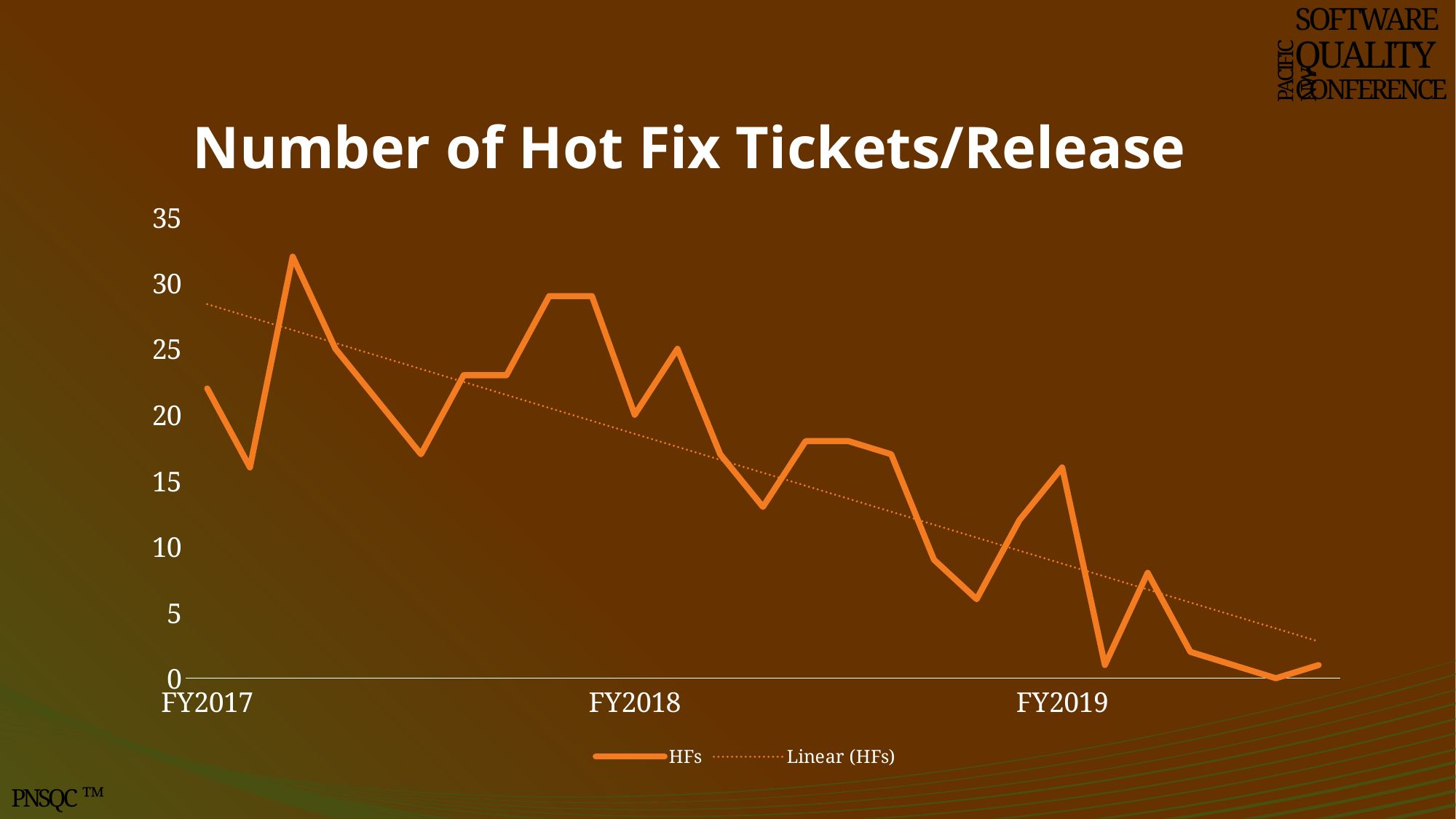
Is the HFs value at the FY2019 label greater or less than 10? greater Does the dotted Linear (HFs) trendline slope upward or downward across the chart? downward What kind of chart is shown on the slide? line chart Is the HFs value at the FY2018 label greater or less than 15? greater What are the two entries in the chart legend? HFs and Linear (HFs) Is the highest point of the HFs line greater or less than 30? greater How many series does the legend list? 2 What is the title of the chart? Number of Hot Fix Tickets/Release In which fiscal year does the HFs line reach its highest peak? FY2017 Overall, do the HFs values rise or fall from FY2017 to FY2019? fall Which is larger, the HFs value at the FY2017 label or at the FY2019 label? FY2017